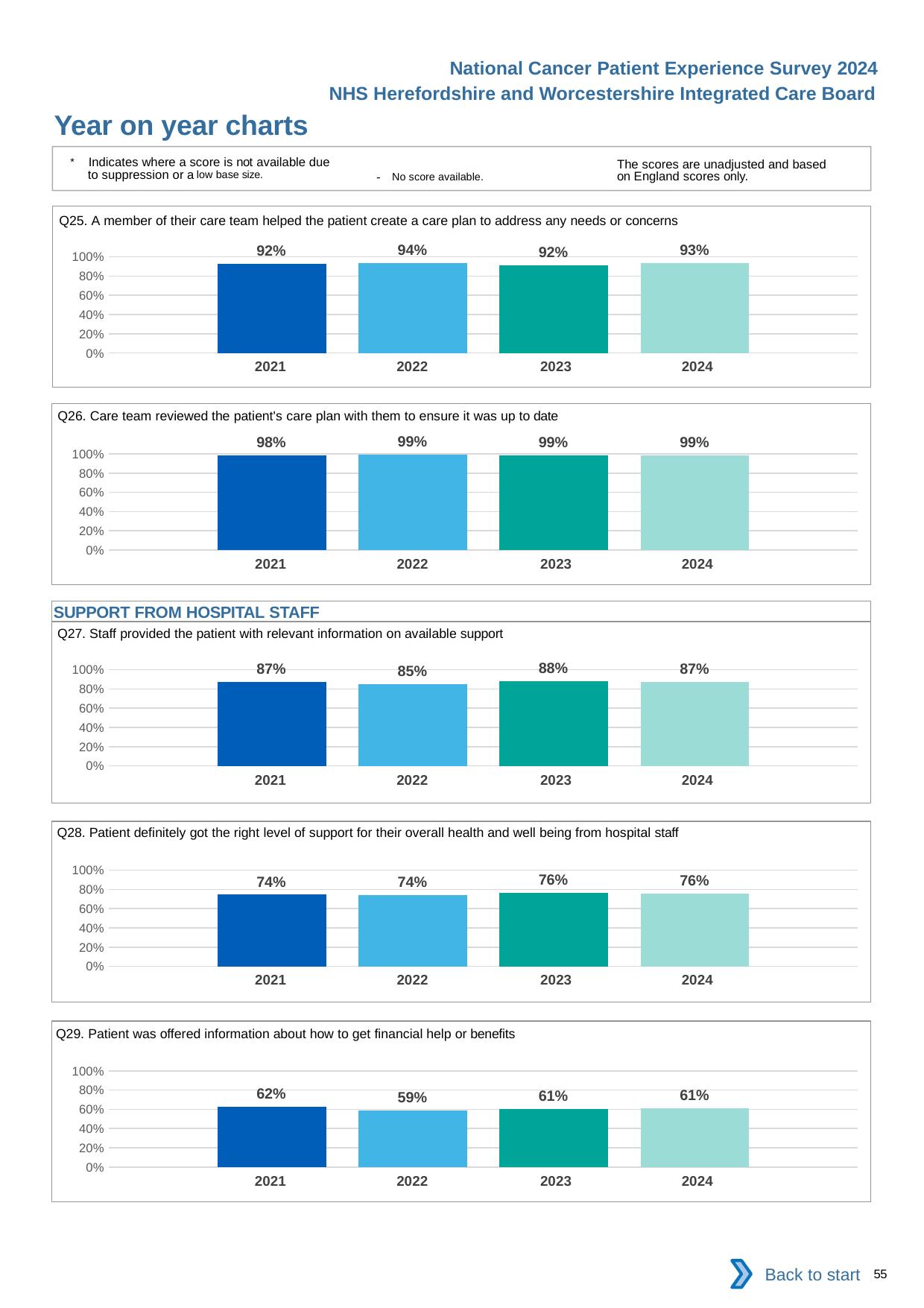
In the Q27 chart, which year has the lowest value? 2022 In the Q26 chart, what is the value for 2021? 98% In the Q27 chart, which year has the highest value? 2023 In the Q29 chart, is the value for 2022 greater or less than 80%? less Which section heading appears above the Q27 chart? SUPPORT FROM HOSPITAL STAFF In the Q25 chart, what is the value for 2022? 94% In the Q29 chart, what is the value for 2024? 61% In the Q28 chart, is the value for 2023 larger or smaller than the value for 2021? larger In the Q29 chart, what is the difference between the 2021 value and the 2022 value? 3% In the Q28 chart, what is the difference between the 2024 value and the 2022 value? 2% What kind of chart is the Q25 chart? bar chart How many years are shown in the Q28 chart? 4